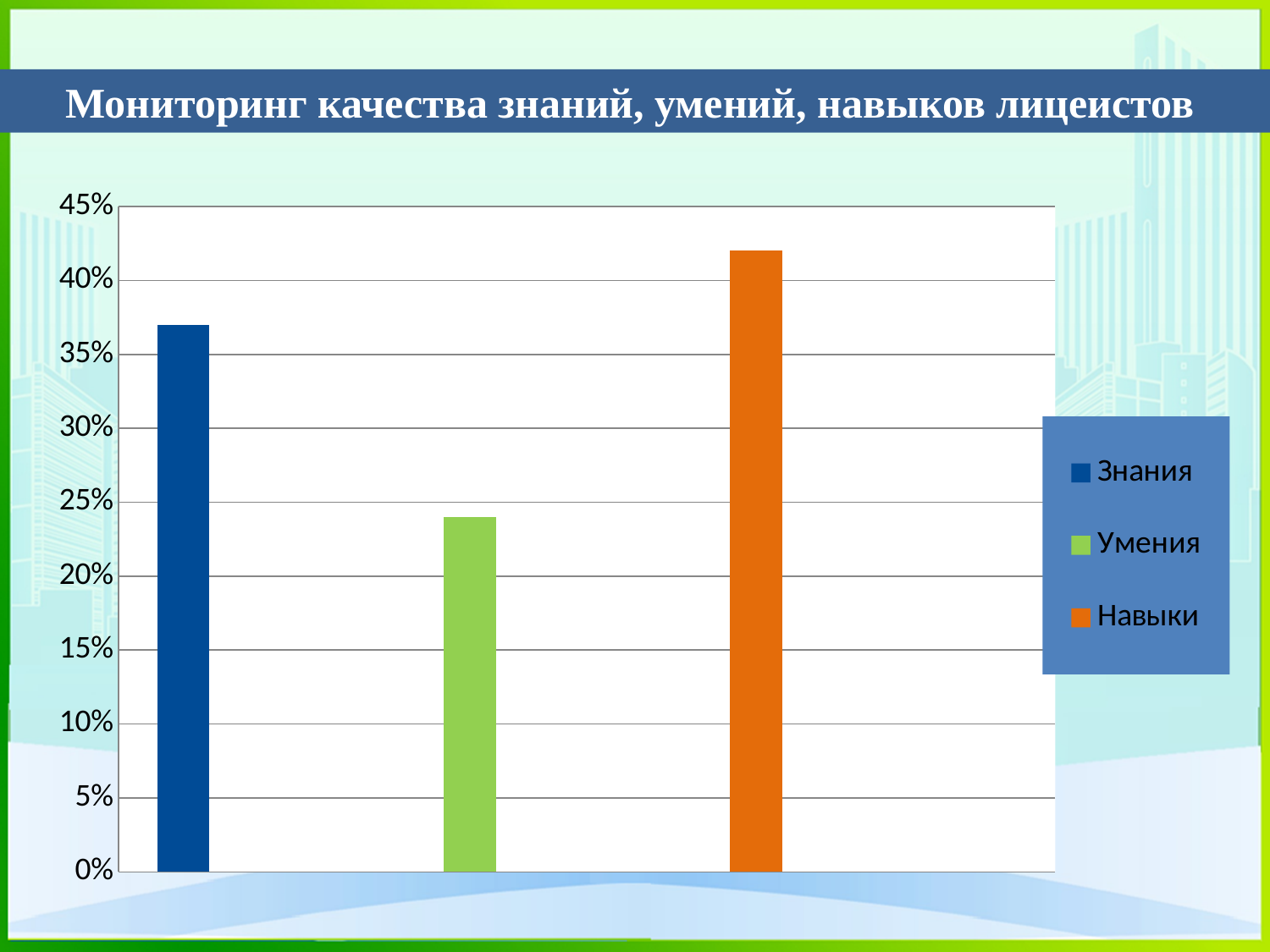
How many series does the legend list? 3 Is the value for Знания greater or less than 40%? less Is the value for Навыки greater or less than 40%? greater Which is larger, the value for Знания or the value for Навыки? Навыки How many bars are plotted on the chart? 3 Which series has the lowest bar? Умения Which is larger, the value for Знания or the value for Умения? Знания Is the value for Умения greater or less than 25%? less Which series has the highest bar? Навыки What colour is the bar for Навыки? orange What kind of chart is shown on the slide? bar chart